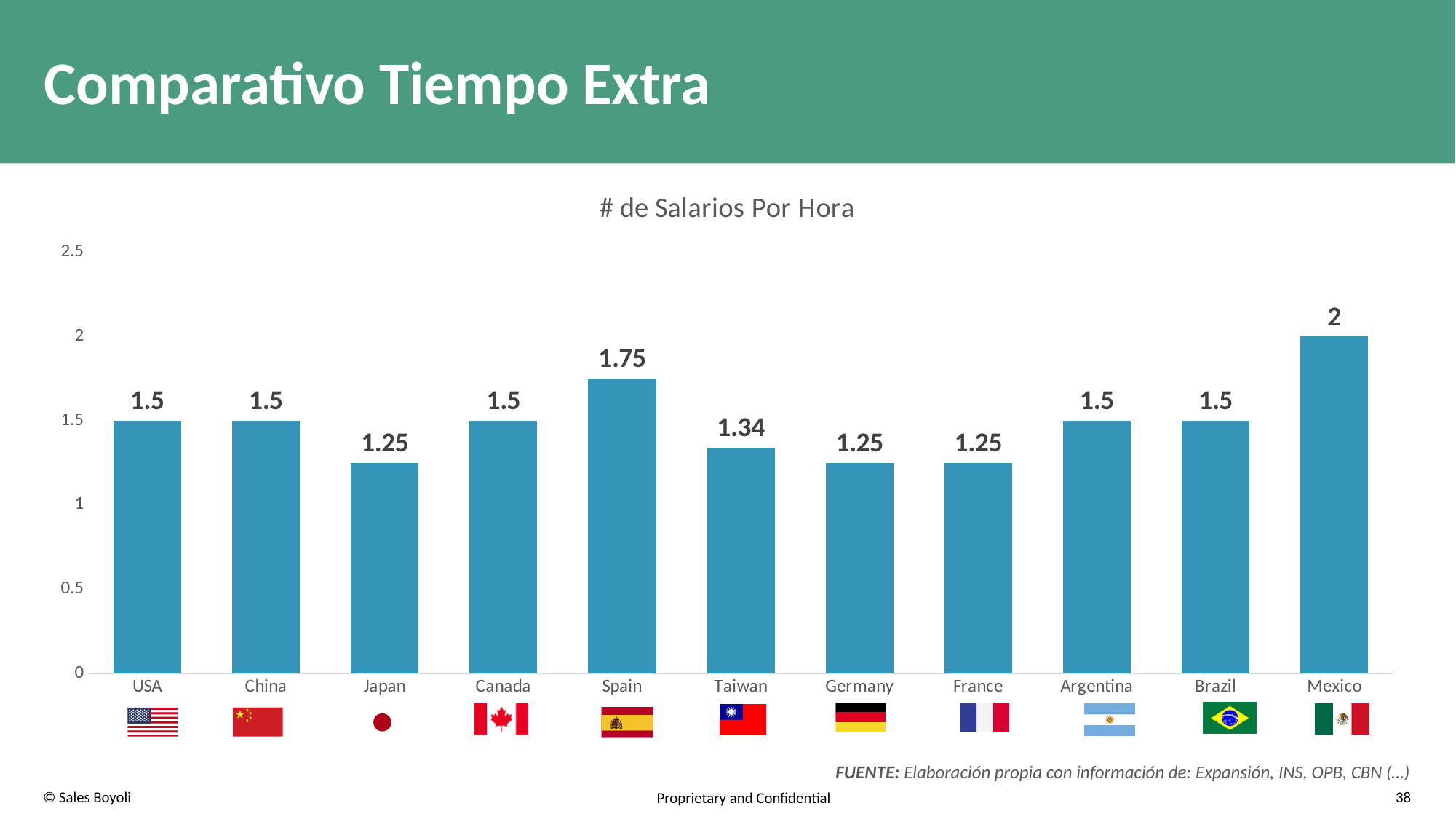
What is the difference between the values for Taiwan and Germany? 0.09 What is the value for Mexico? 2 What is the difference between the values for Mexico and Spain? 0.25 What is the title of the chart? # de Salarios Por Hora What is the value for Spain? 1.75 Which country has the highest value? Mexico How many countries are shown on the x axis? 11 Which is larger, the value for Spain or the value for Canada? Spain Which is larger, the value for Taiwan or the value for France? Taiwan What kind of chart is this? Bar chart What is the value for Taiwan? 1.34 How many countries have a value of 1.25? 3